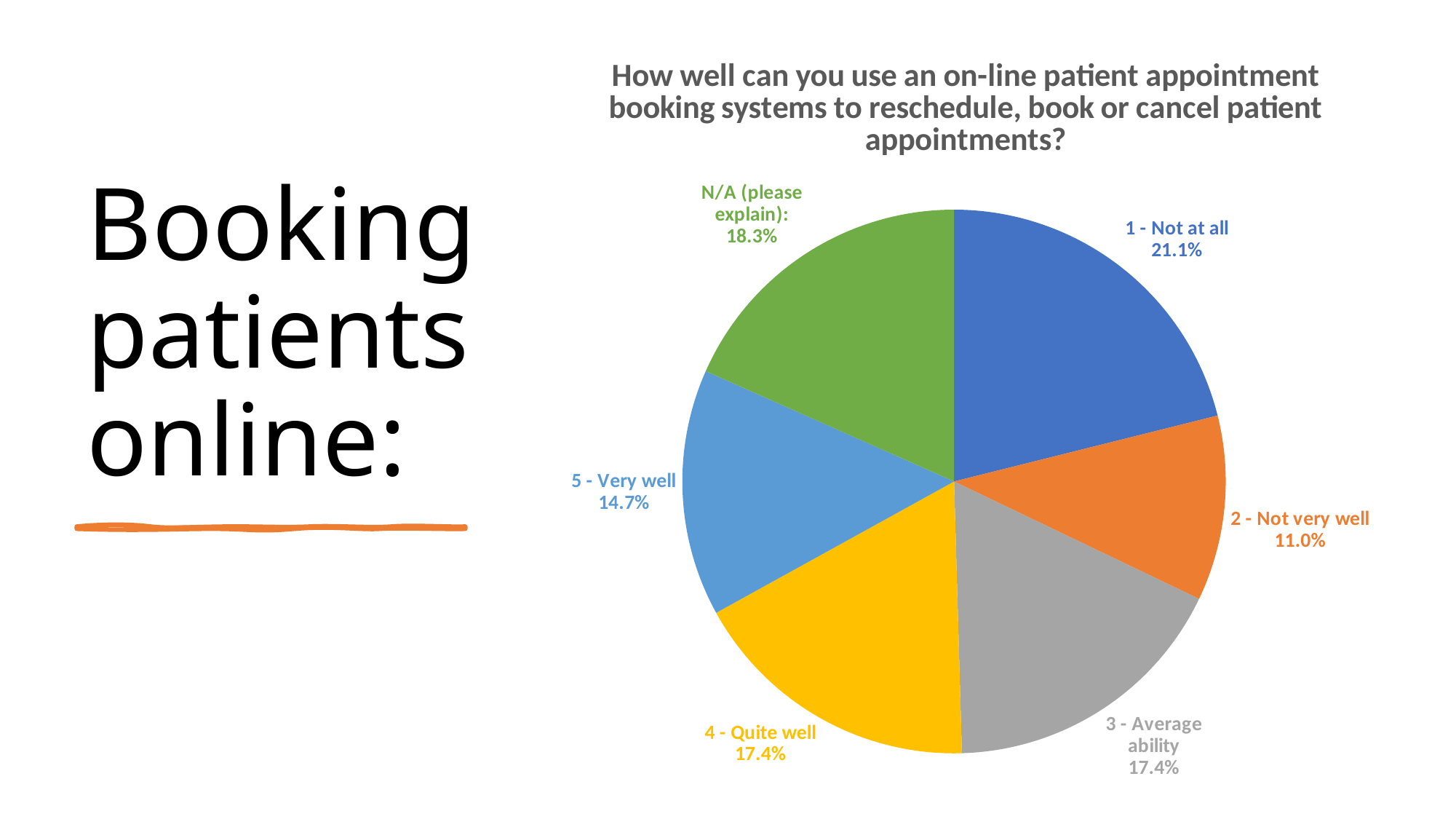
Which response category has the smallest share of the pie? 2 - Not very well What percentage of respondents answered "1 - Not at all"? 21.1% What is the difference in percentage points between "1 - Not at all" and "2 - Not very well"? 10.1 How many slices does the pie chart have? 6 Which response category has the largest share of the pie? 1 - Not at all What kind of chart is shown on the slide? pie chart Which is larger: the share for "N/A (please explain):" or the share for "5 - Very well"? N/A (please explain): What is the combined percentage of "4 - Quite well" and "5 - Very well"? 32.1% What percentage is shown for the "N/A (please explain):" slice? 18.3% What percentage of respondents answered "2 - Not very well"? 11.0% What colour is the "3 - Average ability" slice? grey What percentage of respondents answered "5 - Very well"? 14.7%